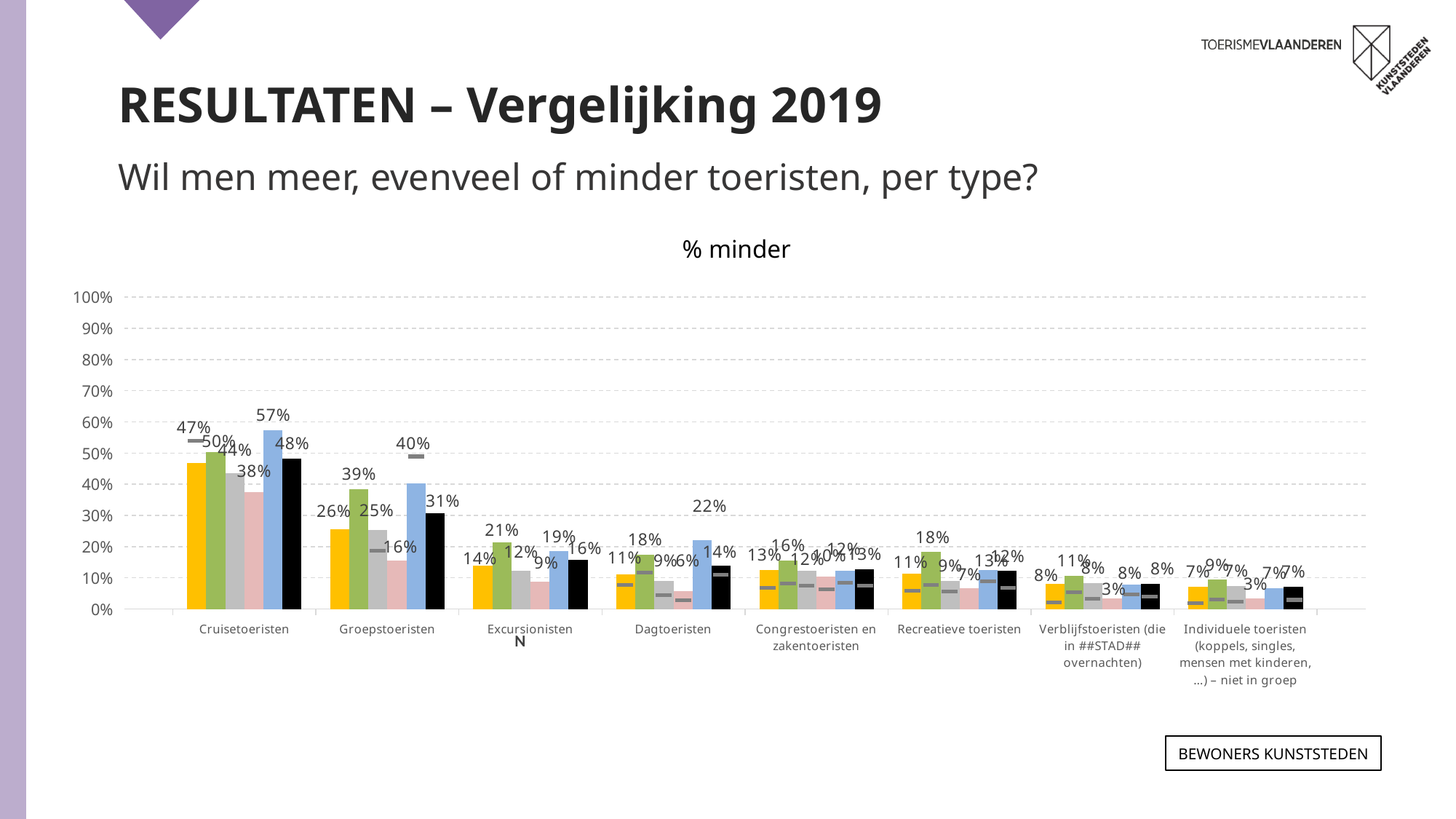
How many tourist-type categories are shown along the x axis of the chart? 8 Which category has the highest value for the blue bar? Cruisetoeristen Which is larger for Dagtoeristen: the blue bar or the green bar? the blue bar What is the difference between the blue bar and the pink bar for Cruisetoeristen? 19% What is the value of the green bar for Groepstoeristen? 39% Do the values of the yellow bars generally rise or fall from Cruisetoeristen to Individuele toeristen along the x axis? fall What is the value of the blue bar for Cruisetoeristen? 57% Is the value of the black bar for Groepstoeristen greater or less than 40%? less What is the value of the pink bar for Verblijfstoeristen (die in ##STAD## overnachten)? 3% What kind of chart is shown on the slide? bar chart Which category has the lowest value for the green bar? Individuele toeristen (koppels, singles, mensen met kinderen, …) – niet in groep What is the title of the chart? % minder